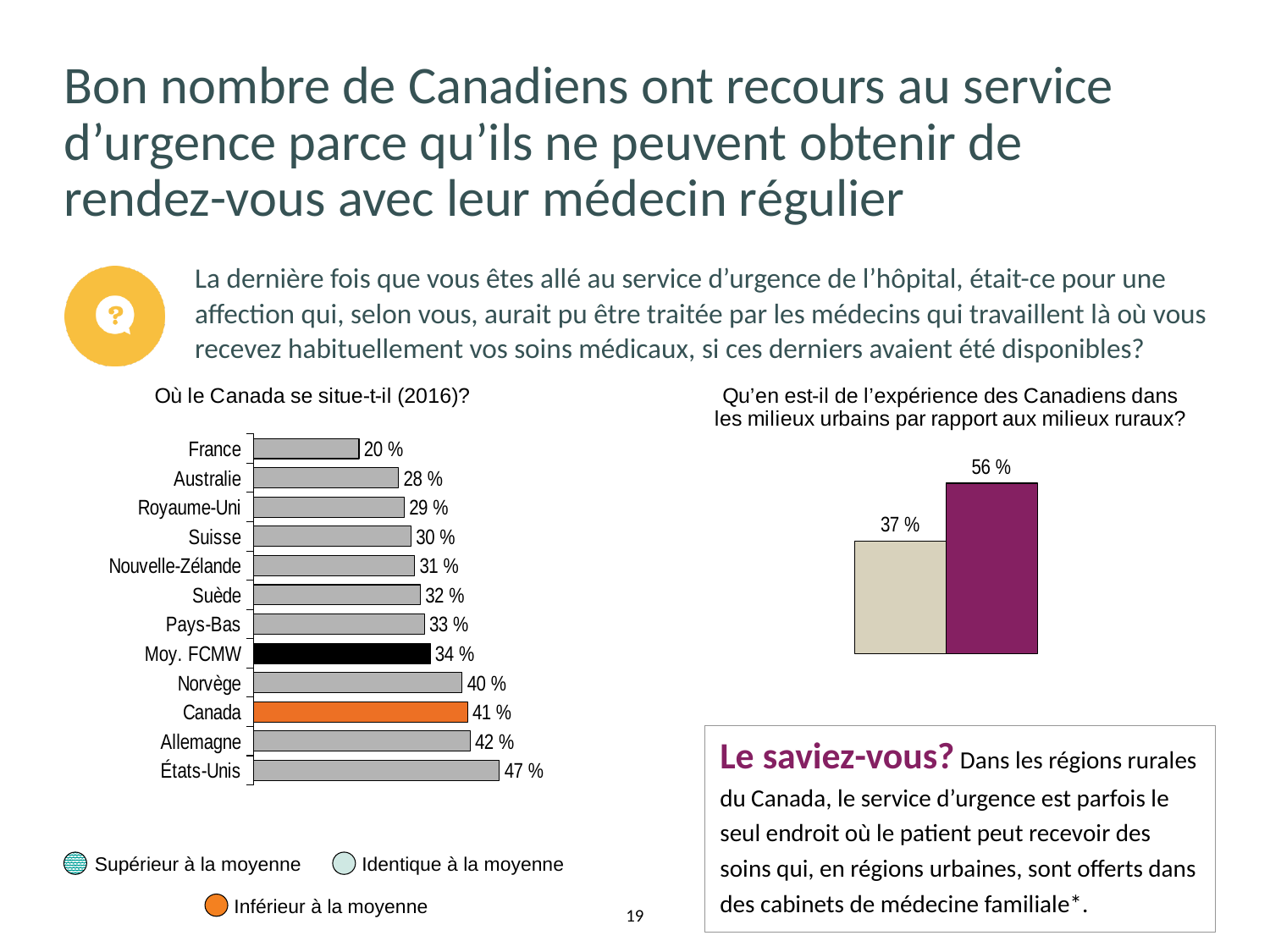
In the chart 'Où le Canada se situe-t-il (2016)?', which country has the highest value? États-Unis In the chart 'Où le Canada se situe-t-il (2016)?', what is the difference between the values for Canada and Moy. FCMW? 7 % In the chart 'Où le Canada se situe-t-il (2016)?', which has a larger value, Norvège or Suède? Norvège How many countries or categories are shown in the chart 'Où le Canada se situe-t-il (2016)?'? 12 What kind of chart is 'Où le Canada se situe-t-il (2016)?'? Bar chart In the chart 'Où le Canada se situe-t-il (2016)?', what colour is the bar for Canada? Orange In the chart 'Où le Canada se situe-t-il (2016)?', what is the value for Canada? 41 % In the chart 'Où le Canada se situe-t-il (2016)?', what is the value for Moy. FCMW? 34 % In the chart on the right about urban versus rural experience, what is the difference between the two bars? 19 % In the chart 'Où le Canada se situe-t-il (2016)?', which country has the lowest value? France In the chart on the right about urban versus rural experience, what is the value of the taller bar? 56 % In the chart 'Où le Canada se situe-t-il (2016)?', what is the value for France? 20 %